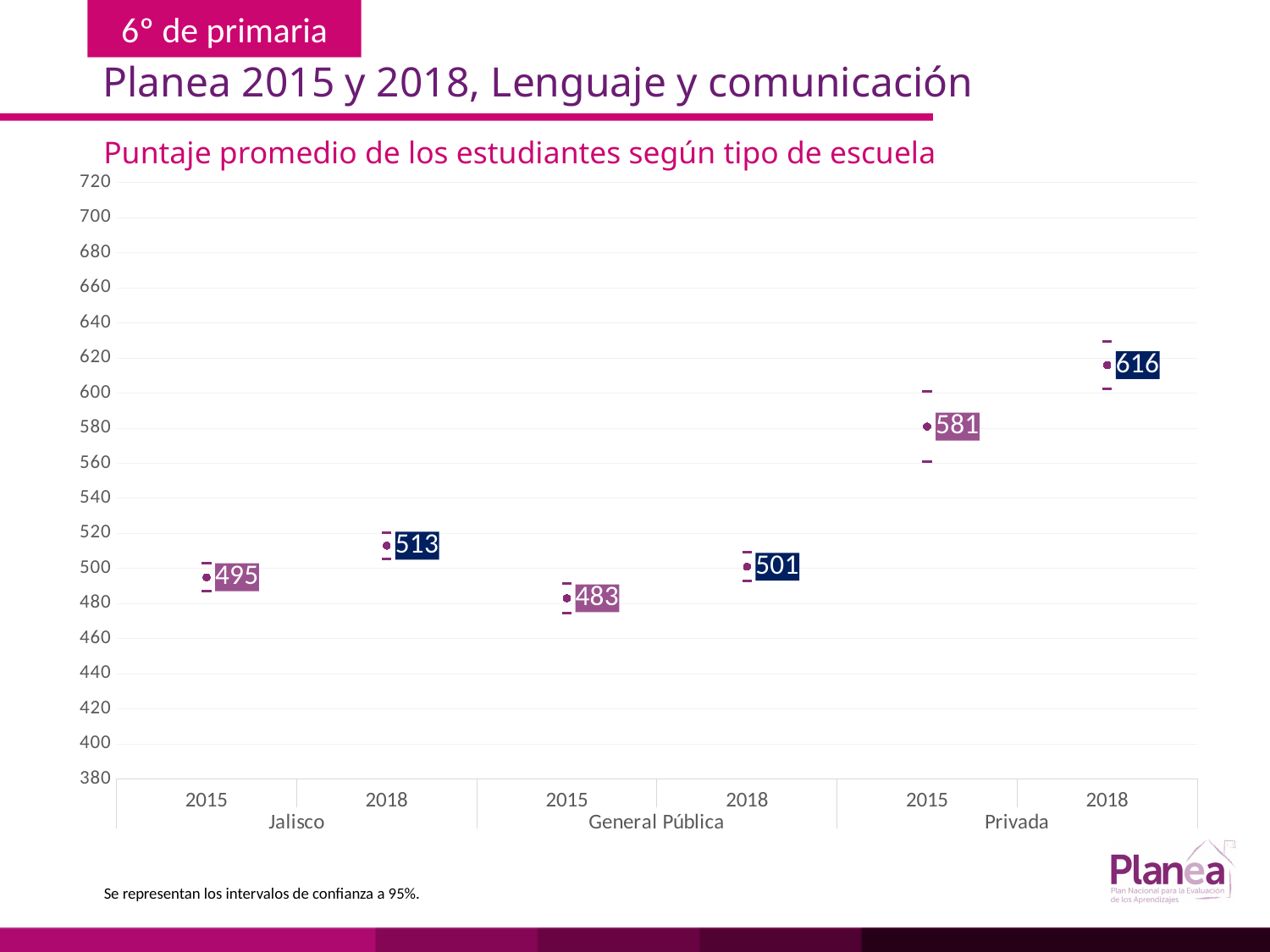
Did the average score for General Pública rise or fall from 2015 to 2018? Rise Which school type and year has the lowest average score? General Pública 2015 What is the difference between the Jalisco 2018 score and the General Pública 2018 score? 12 Which school type and year has the highest average score? Privada 2018 Which is larger, the Jalisco 2015 score or the General Pública 2015 score? Jalisco 2015 What is the average score for Jalisco in 2018? 513 How many data points are plotted on the chart? 6 By how many points did the Privada average score increase from 2015 to 2018? 35 What is the average score for Jalisco in 2015? 495 What is the average score for Privada in 2018? 616 What is the title of the chart? Puntaje promedio de los estudiantes según tipo de escuela What is the average score for General Pública in 2015? 483